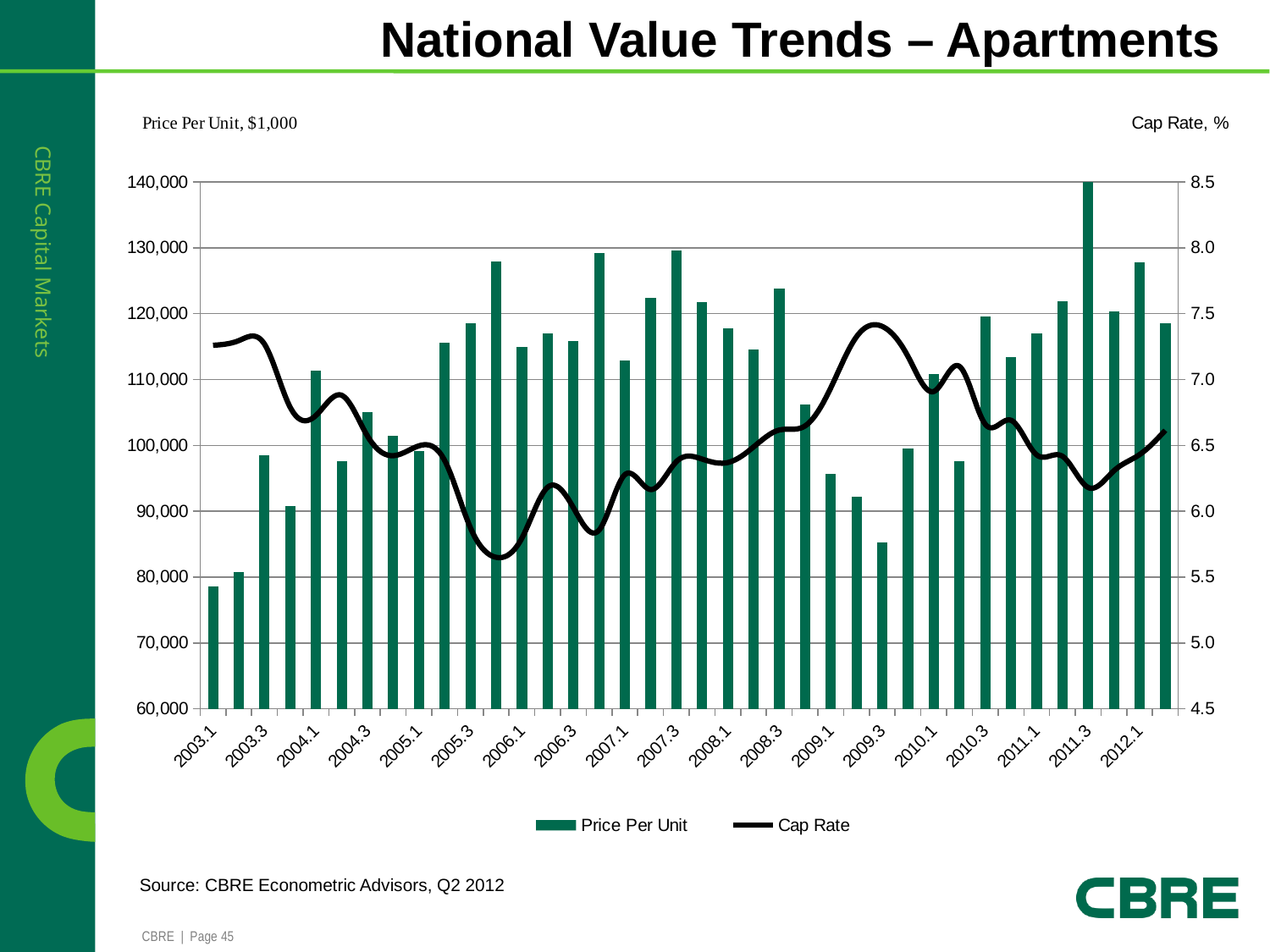
Does the Cap Rate line end higher or lower at 2012 than it started in 2003? lower What kind of chart is shown on the slide? A combination bar and line chart Is the Cap Rate at 2003.1 greater or less than 7.0? greater In which quarter is the Price Per Unit bar highest? 2011.3 How many series does the legend list? 2 Is the Cap Rate at 2006.1 greater or less than 6.0? less Is the Price Per Unit value for 2003.1 greater or less than 80,000? less Which has the larger Price Per Unit bar, 2007.1 or 2007.3? 2007.3 In which quarter is the Price Per Unit bar lowest? 2003.1 What is the title of the chart? National Value Trends – Apartments Which series is drawn as bars? Price Per Unit